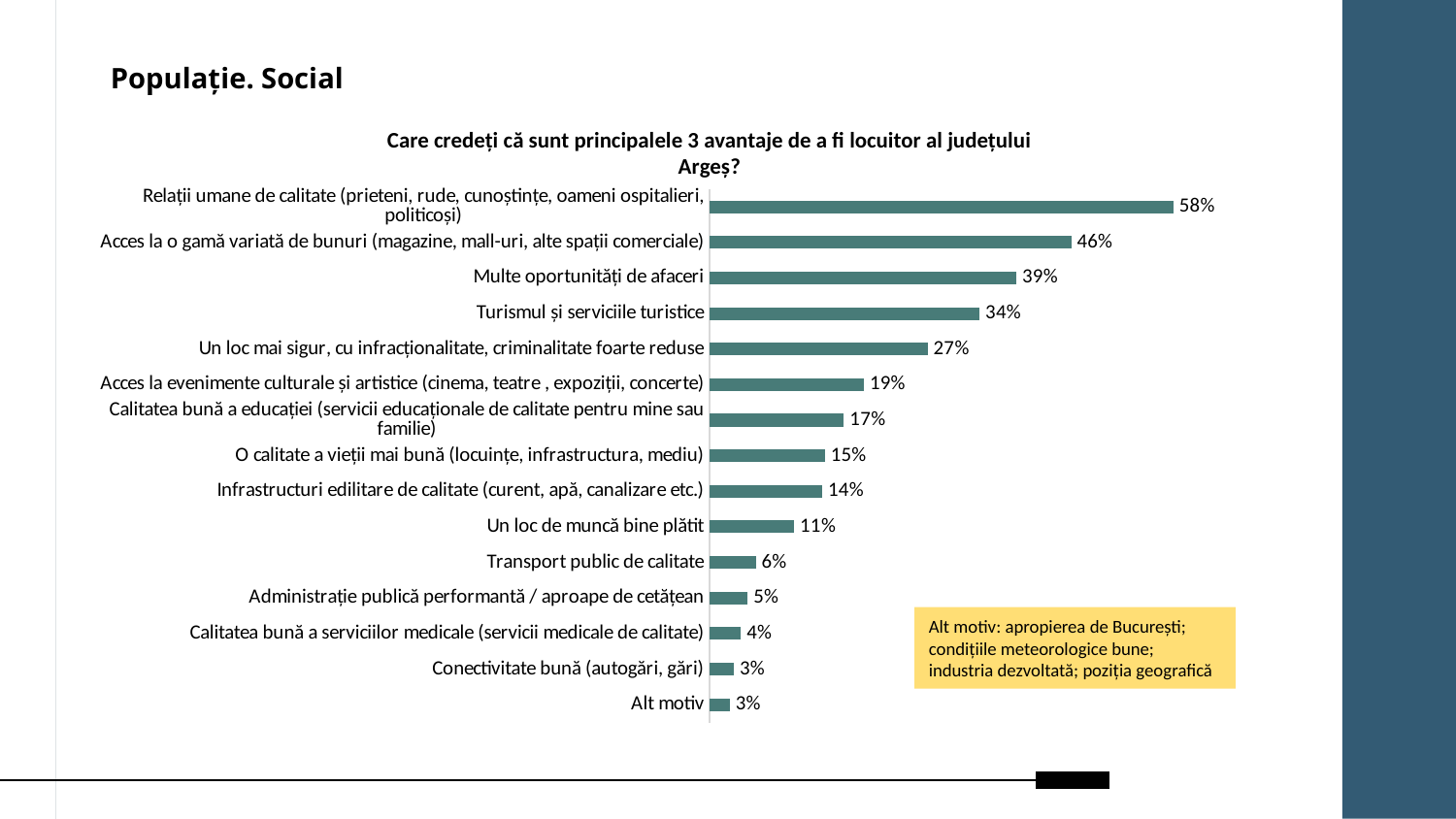
What is the value for "Un loc de muncă bine plătit"? 11% What is the title of the chart? Care credeți că sunt principalele 3 avantaje de a fi locuitor al județului Argeș? What is the value for "Multe oportunități de afaceri"? 39% Which category has the highest value? Relații umane de calitate (prieteni, rude, cunoștințe, oameni ospitalieri, politicoși) What is the value for "Turismul și serviciile turistice"? 34% How many categories are shown in the chart? 15 What kind of chart is shown on the slide? Bar chart Which is larger: the value for "Transport public de calitate" or the value for "Administrație publică performantă / aproape de cetățean"? Transport public de calitate What is the value for "Calitatea bună a serviciilor medicale (servicii medicale de calitate)"? 4% What is the difference between the values for "Relații umane de calitate" and "Un loc mai sigur, cu infracționalitate, criminalitate foarte reduse"? 31% Which category has the lowest value among the named advantages (excluding "Alt motiv")? Conectivitate bună (autogări, gări) What is the difference between the values for "Acces la o gamă variată de bunuri" and "Multe oportunități de afaceri"? 7%